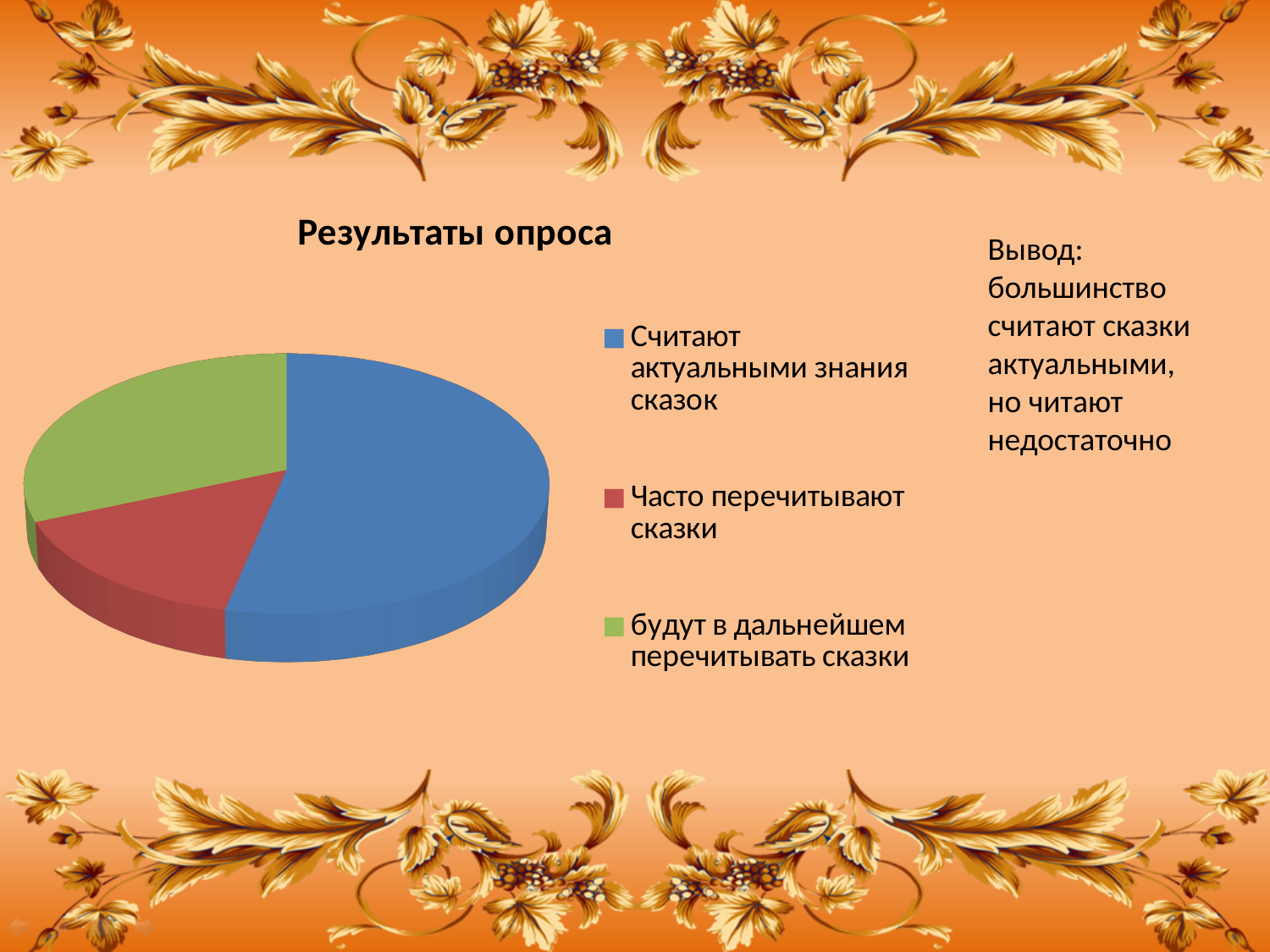
How many entries does the chart legend list? 3 How many slices does the pie chart have? 3 What is the title of the chart? Результаты опроса What colour is the slice for "будут в дальнейшем перечитывать сказки"? green What kind of chart is shown on the slide? pie chart Which category has the smallest slice of the pie? Часто перечитывают сказки Which slice is larger: "Считают актуальными знания сказок" or "Часто перечитывают сказки"? Считают актуальными знания сказок Which slice is larger: "будут в дальнейшем перечитывать сказки" or "Часто перечитывают сказки"? будут в дальнейшем перечитывать сказки Which category has the largest slice of the pie? Считают актуальными знания сказок